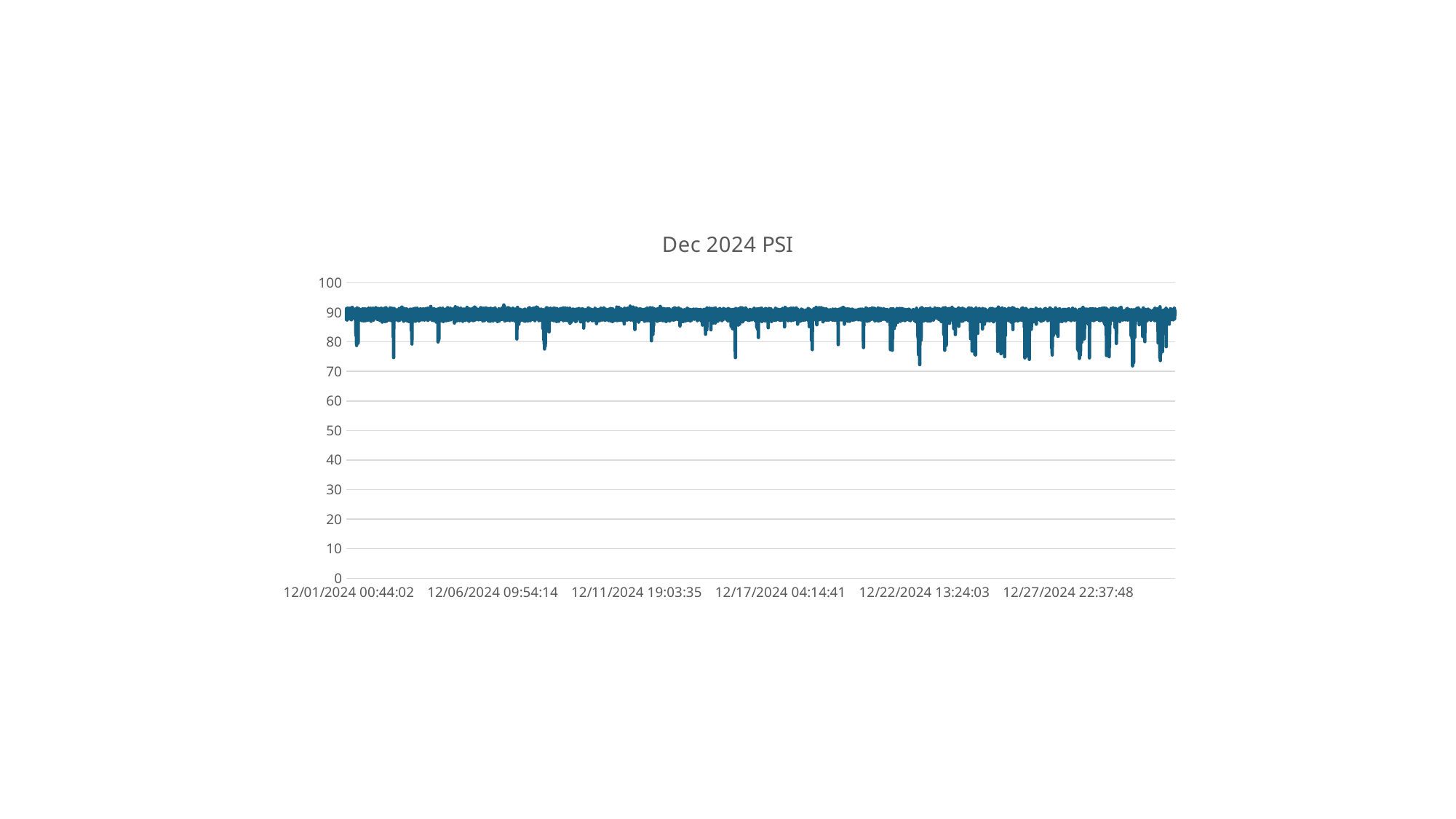
Is the highest value plotted on the chart greater or less than 100? less Does the overall level of the line rise sharply, fall sharply, or stay roughly flat across December? stay roughly flat How many lines (series) are plotted on the chart? 1 Do the values on the chart ever drop below 50? No Around which y-axis gridline do most of the plotted values sit? 90 What is the title of the chart? Dec 2024 PSI Is the value at 12/01/2024 00:44:02 greater or less than 50? greater How many date labels are shown along the x axis? 6 What colour is the plotted line? blue What kind of chart is shown on the slide? line chart